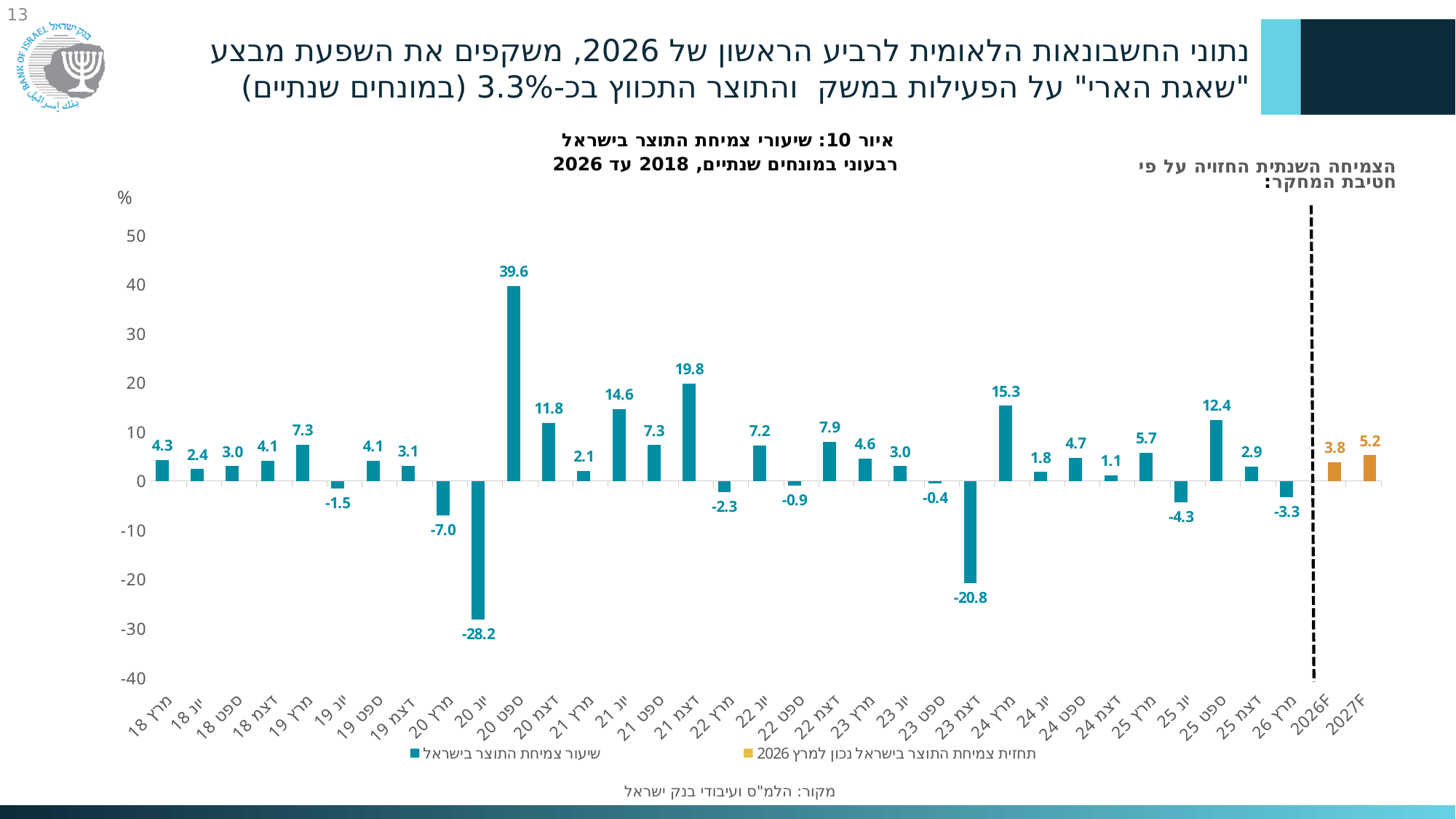
How many series does the legend list? 2 Which is larger, the value for דצמ 21 or the value for מרץ 24? דצמ 21 What is the forecast value for 2027F? 5.2 What is the value for ספט 20 (September 2020)? 39.6 What is the value for יונ 20 (June 2020)? -28.2 Is the value for דצמ 23 greater or less than -10? less What is the difference between the 2027F and 2026F forecast values? 1.4 Which category has the lowest value? יונ 20 What colour are the forecast bars for 2026F and 2027F? orange What is the value for מרץ 26 (March 2026)? -3.3 What kind of chart is shown? bar chart Which category has the highest value? ספט 20